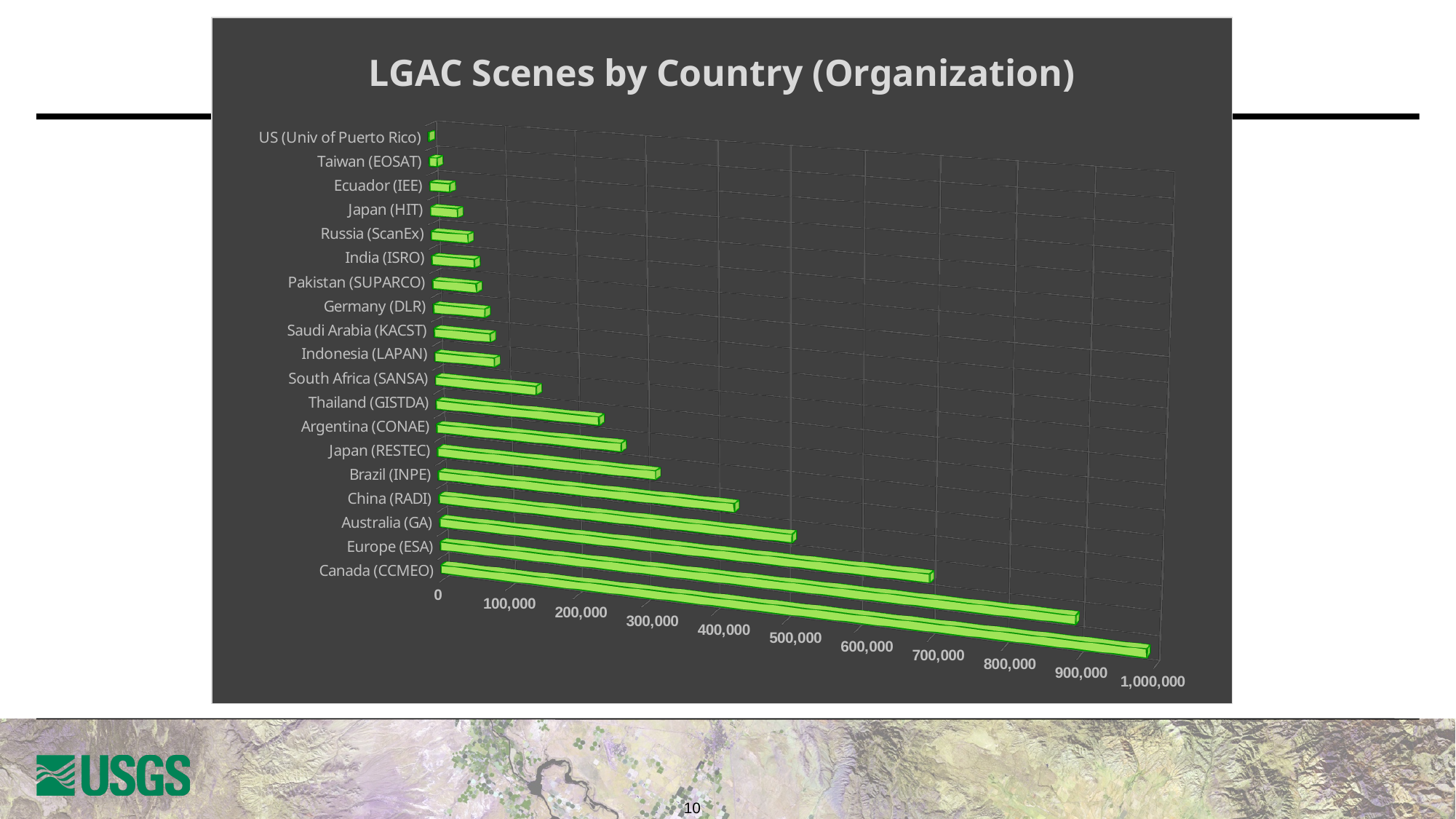
What kind of chart is shown on the slide? bar chart Is the value for Europe (ESA) greater or less than 800,000? greater How many countries (organizations) are listed on the chart? 19 Is the value for Indonesia (LAPAN) greater or less than 200,000? less What is the title of the chart? LGAC Scenes by Country (Organization) Which has more LGAC scenes, China (RADI) or Brazil (INPE)? China (RADI) Is the value for Canada (CCMEO) greater or less than 900,000? greater Which country (organization) has the highest number of LGAC scenes? Canada (CCMEO) Which country (organization) has the lowest number of LGAC scenes? US (Univ of Puerto Rico)